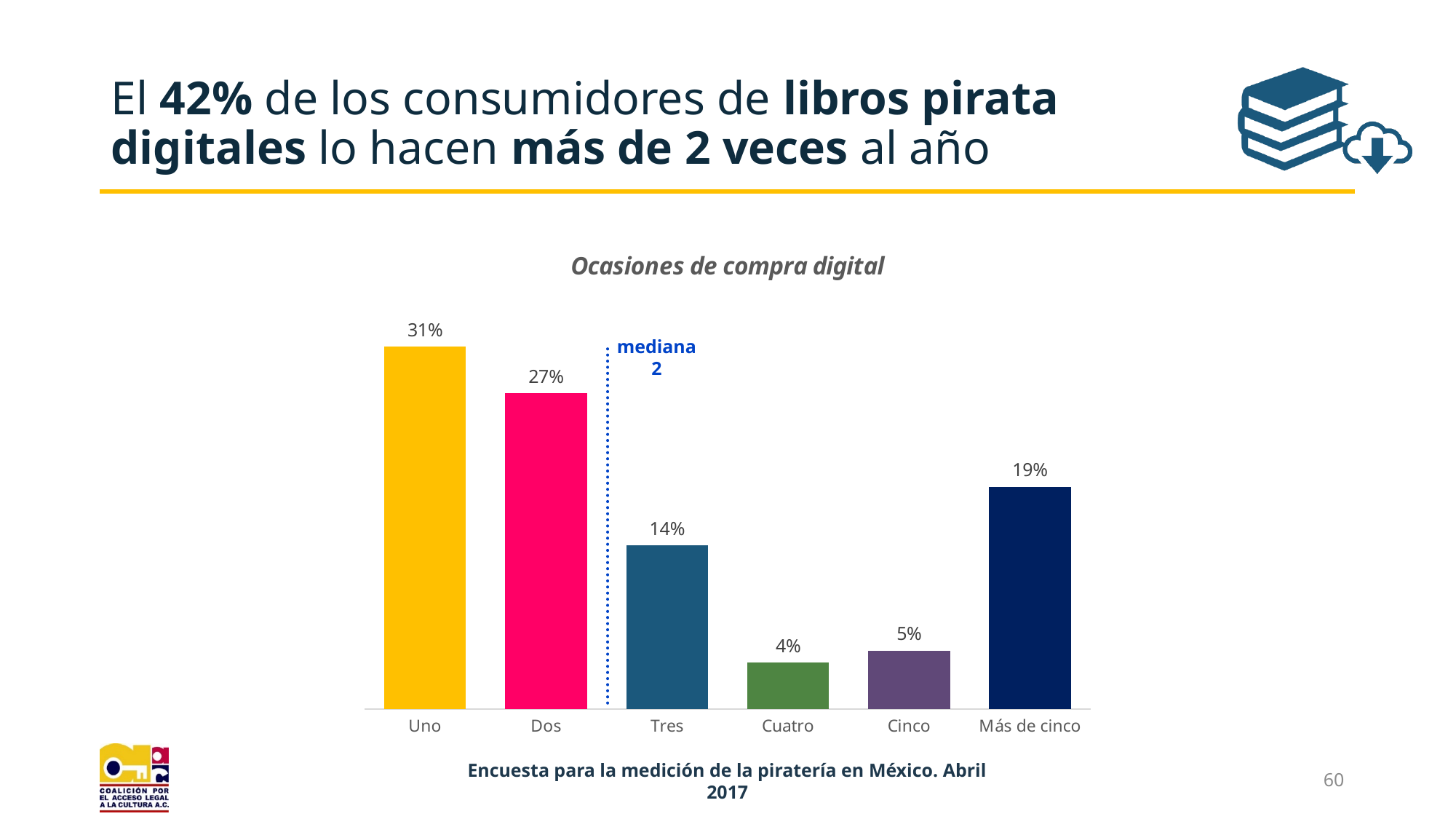
How many categories are shown on the x axis of the chart? 6 Which category has the lowest value? Cuatro What is the value for "Uno" in the chart? 31% Which is larger, the value for "Cinco" or the value for "Cuatro"? Cinco What kind of chart is shown on the slide? Bar chart What is the title of the chart? Ocasiones de compra digital What is the difference between the values for "Más de cinco" and "Tres"? 5% What is the difference between the values for "Uno" and "Dos"? 4% Which category has the highest value? Uno What is the value for "Más de cinco" in the chart? 19% What is the value for "Cuatro" in the chart? 4% What value does the dotted line labelled "mediana" indicate? 2